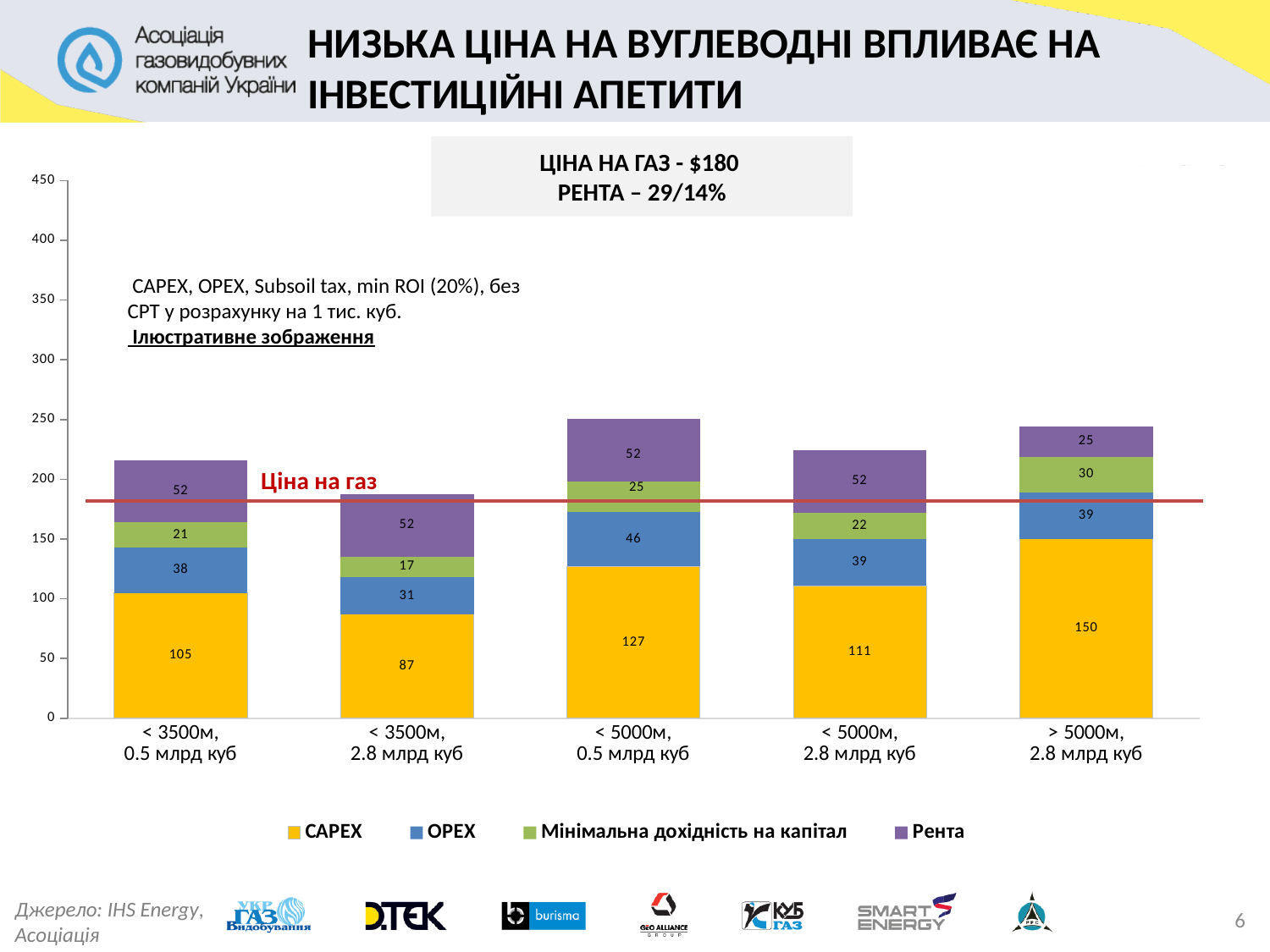
What is the CAPEX value for the category '> 5000м, 2.8 млрд куб'? 150 Which category has the highest CAPEX value? > 5000м, 2.8 млрд куб How many series does the legend list? 4 Which is larger: the OPEX value for '< 3500м, 0.5 млрд куб' or the OPEX value for '< 3500м, 2.8 млрд куб'? < 3500м, 0.5 млрд куб What is the label of the horizontal red line drawn across the chart? Ціна на газ What is the OPEX value for the category '< 5000м, 0.5 млрд куб'? 46 What is the Рента value for the category '> 5000м, 2.8 млрд куб'? 25 What is the total of the stacked bar for '< 5000м, 0.5 млрд куб'? 250 What type of chart is shown on the slide? Stacked bar chart Which category has the lowest CAPEX value? < 3500м, 2.8 млрд куб How many categories are shown on the x axis? 5 What is the difference between the CAPEX values for '< 5000м, 0.5 млрд куб' and '< 5000м, 2.8 млрд куб'? 16